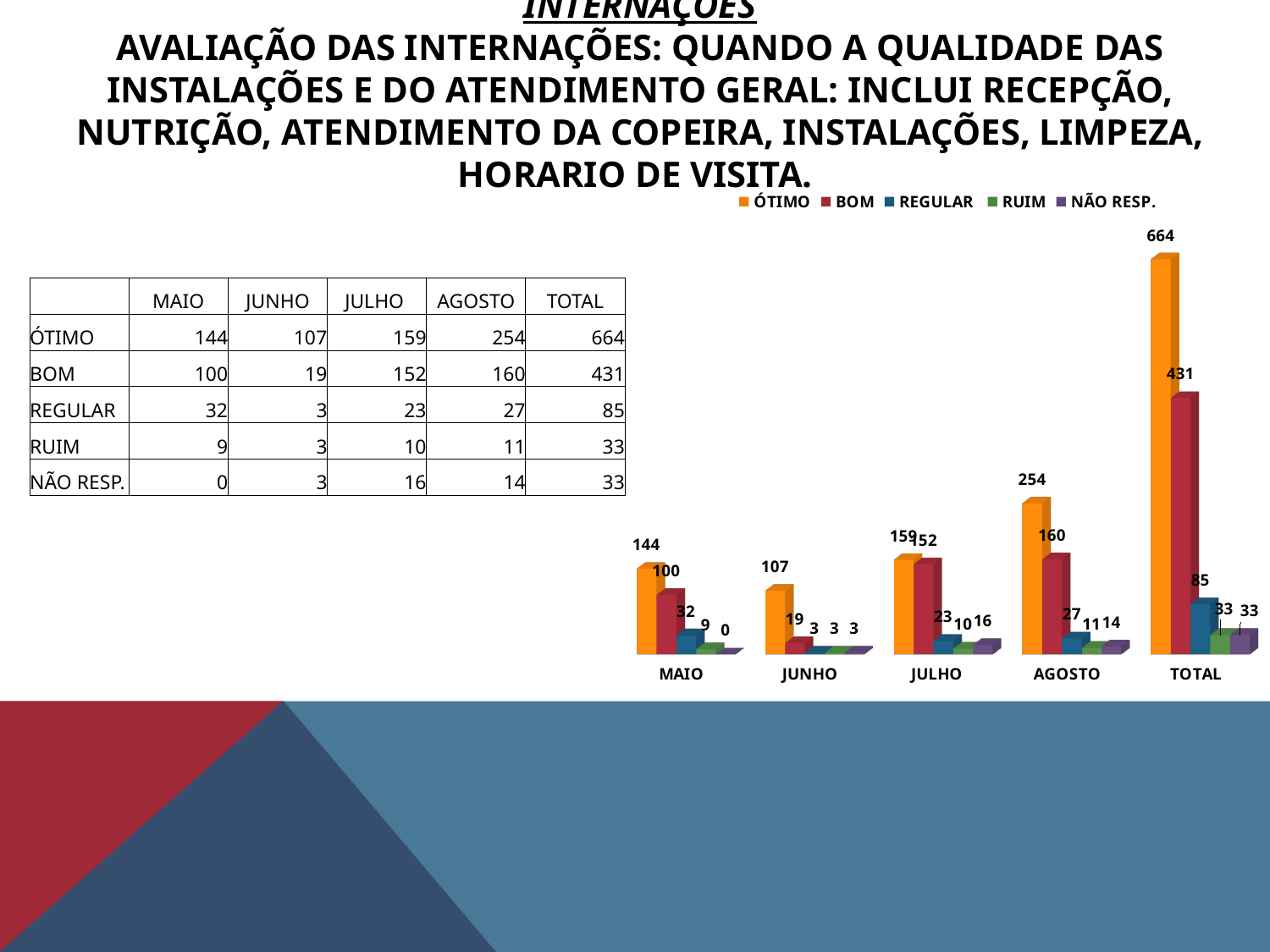
How many series does the chart legend list? 5 What is the value of REGULAR for TOTAL in the chart? 85 Which month has the lowest BOM value in the chart? JUNHO What is the value of BOM for JUNHO in the chart? 19 Which month has the highest ÓTIMO value in the chart (excluding TOTAL)? AGOSTO What kind of chart is shown on the slide? bar chart What is the value of ÓTIMO for AGOSTO in the chart? 254 How many categories are shown along the x axis of the chart? 5 Which is larger in the chart: ÓTIMO for JULHO or BOM for JULHO? ÓTIMO for JULHO Which series is shown in orange in the chart legend? ÓTIMO What is the difference between the ÓTIMO and BOM values for TOTAL in the chart? 233 What is the value of NÃO RESP. for MAIO in the chart? 0